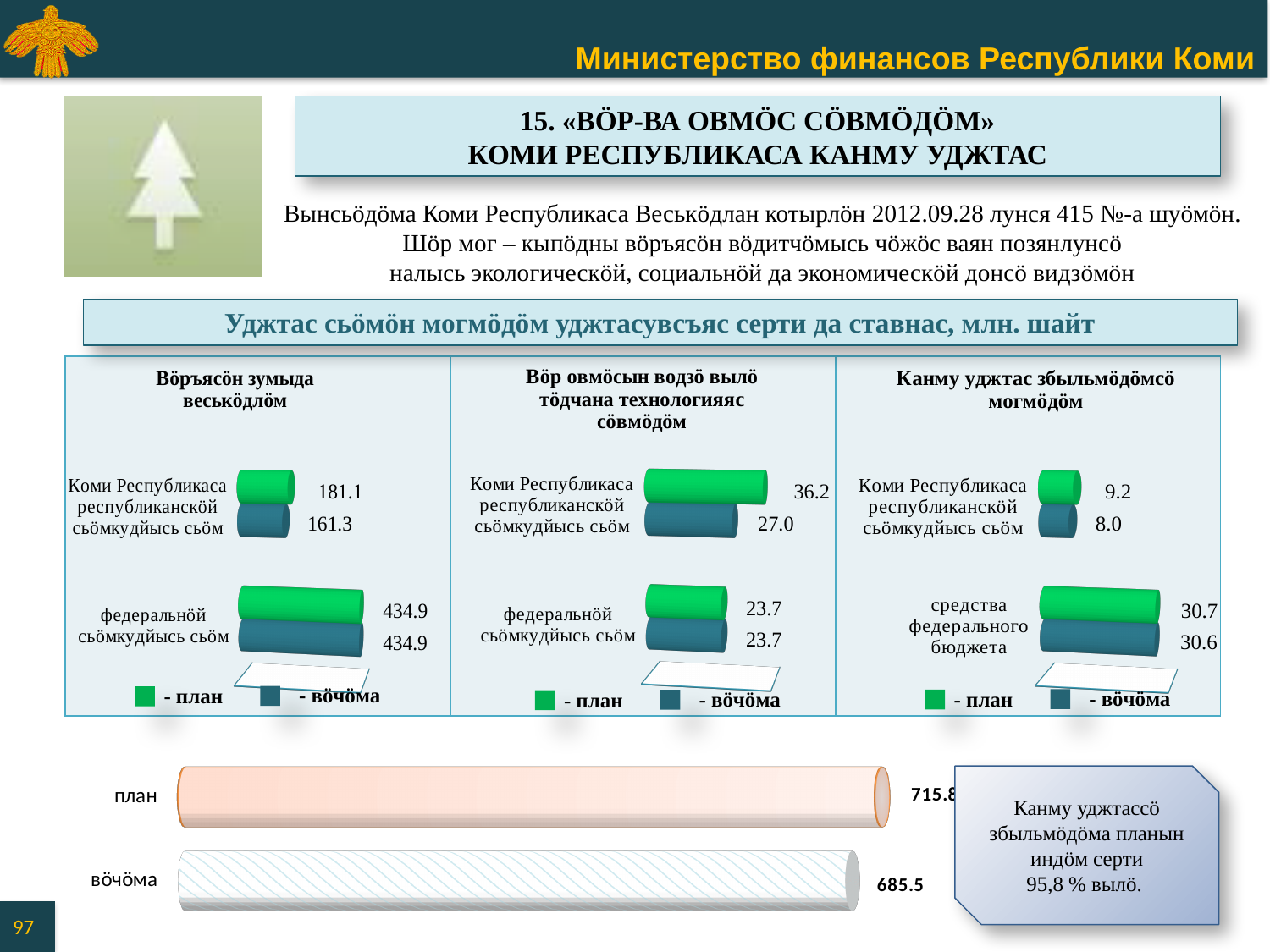
In the left chart titled «Вöръясöн зумыда веськöдлöм», what is the difference between the план and вöчöма values for «Коми Республикаса республиканскöй сьöмкудйысь сьöм»? 19.8 In the middle chart titled «Вöр овмöсын водзö вылö тöдчана технологияяс сöвмöдöм», which category has the higher план value? Коми Республикаса республиканскöй сьöмкудйысь сьöм In the middle chart titled «Вöр овмöсын водзö вылö тöдчана технологияяс сöвмöдöм», what is the вöчöма value for «Коми Республикаса республиканскöй сьöмкудйысь сьöм»? 27.0 What kind of chart is the bottom chart showing «план» and «вöчöма»? bar chart In the left chart titled «Вöръясöн зумыда веськöдлöм», what is the вöчöма value for «федеральнöй сьöмкудйысь сьöм»? 434.9 In the left chart titled «Вöръясöн зумыда веськöдлöм», what is the план value for «Коми Республикаса республиканскöй сьöмкудйысь сьöм»? 181.1 In the bottom chart, what is the value for «вöчöма»? 685.5 In the right chart titled «Канму уджтас збыльмöдöмсö могмöдöм», what is the difference between the план and вöчöма values for «Коми Республикаса республиканскöй сьöмкудйысь сьöм»? 1.2 In the right chart titled «Канму уджтас збыльмöдöмсö могмöдöм», what is the план value for «средства федерального бюджета»? 30.7 In the bottom chart, which of the two bars is larger, «план» or «вöчöма»? план How many series does the legend of the left chart titled «Вöръясöн зумыда веськöдлöм» list? 2 In the right chart titled «Канму уджтас збыльмöдöмсö могмöдöм», which is larger: the план value for «Коми Республикаса республиканскöй сьöмкудйысь сьöм» or the план value for «средства федерального бюджета»? средства федерального бюджета